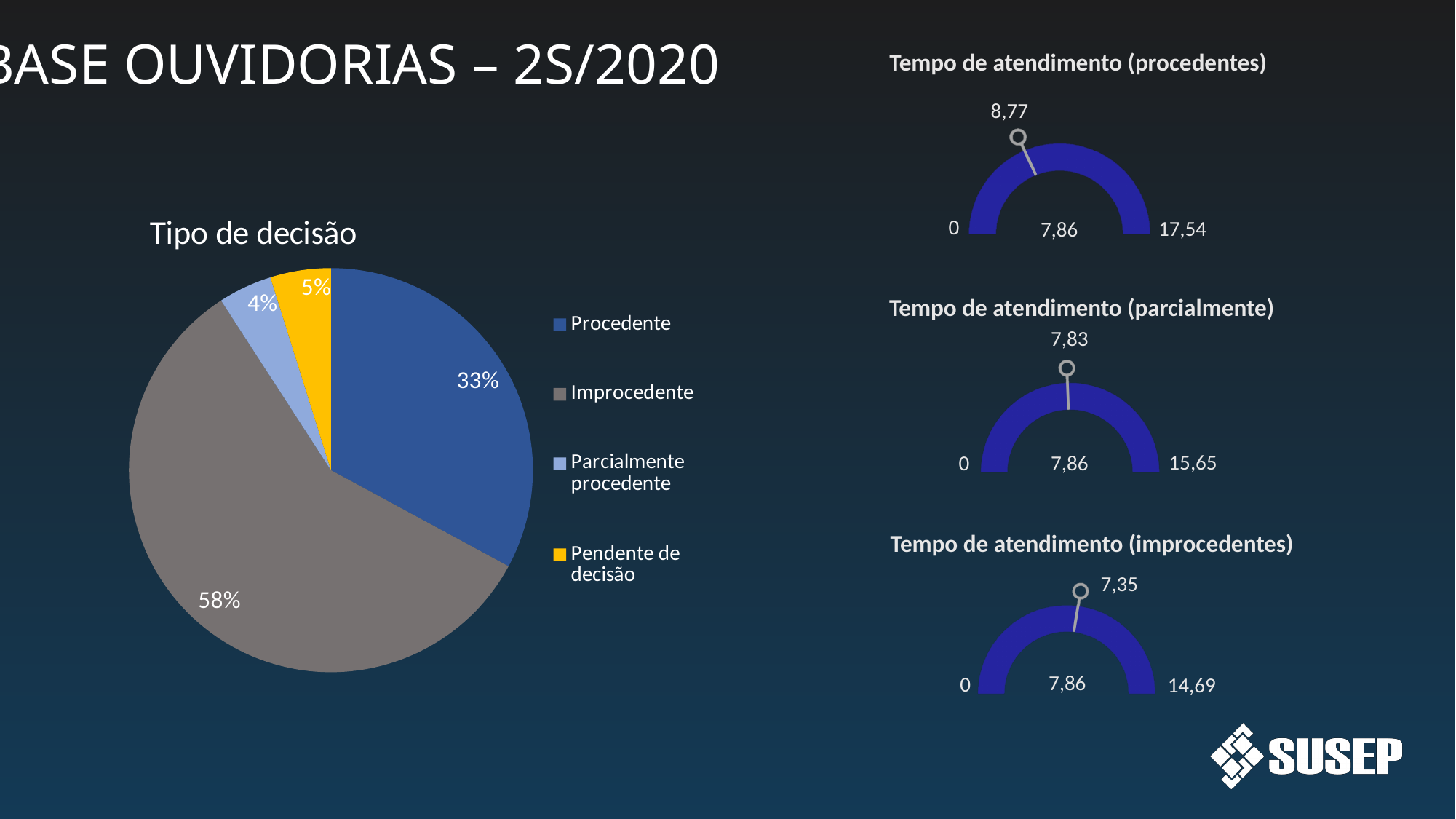
In the 'Tipo de decisão' chart, what percentage is shown for Improcedente? 58% In the 'Tipo de decisão' chart, how many categories does the legend list? 4 In the 'Tempo de atendimento (improcedentes)' gauge, what is the maximum value shown on the scale? 14,69 What kind of chart is 'Tipo de decisão'? Pie chart In the 'Tipo de decisão' chart, what percentage is shown for Procedente? 33% In the 'Tipo de decisão' chart, which category has the smallest share? Parcialmente procedente In the 'Tipo de decisão' chart, what percentage is shown for Pendente de decisão? 5% In the 'Tempo de atendimento (procedentes)' gauge, what value does the needle indicate? 8,77 Which is larger: the value on the 'Tempo de atendimento (procedentes)' gauge or the value on the 'Tempo de atendimento (improcedentes)' gauge? Tempo de atendimento (procedentes) In the 'Tipo de decisão' chart, what is the difference in percentage points between Improcedente and Procedente? 25 In the 'Tempo de atendimento (parcialmente)' gauge, what value does the needle indicate? 7,83 In the 'Tipo de decisão' chart, which category has the largest share? Improcedente